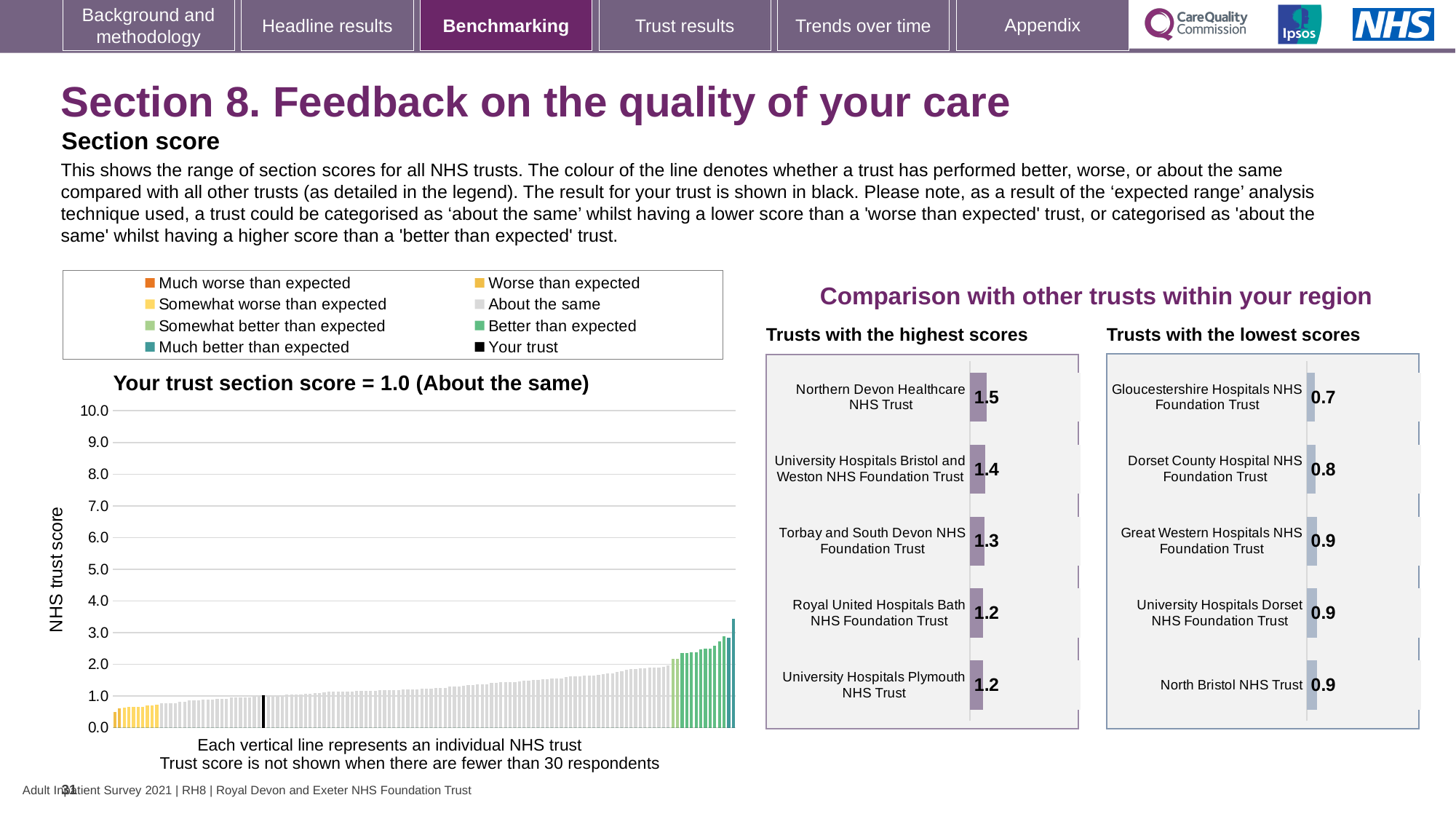
In the 'Trusts with the highest scores' chart, which trust has the highest score? Northern Devon Healthcare NHS Trust In the 'Trusts with the lowest scores' chart, which trust has the lowest score? Gloucestershire Hospitals NHS Foundation Trust In the 'Trusts with the lowest scores' chart, what is the score for Dorset County Hospital NHS Foundation Trust? 0.8 How many entries does the legend of the main section score chart list? 8 In the 'Trusts with the highest scores' chart, what is the score for Northern Devon Healthcare NHS Trust? 1.5 How many trusts are shown in the 'Trusts with the lowest scores' chart? 5 In the 'Trusts with the highest scores' chart, what is the score for Torbay and South Devon NHS Foundation Trust? 1.3 In the 'Trusts with the lowest scores' chart, what is the score for Gloucestershire Hospitals NHS Foundation Trust? 0.7 According to the main 'Your trust section score' chart, what is the section score for your trust? 1.0 In the main 'Your trust section score' chart, do the trust scores rise or fall from left to right? rise In the 'Trusts with the highest scores' chart, which has the larger score: University Hospitals Bristol and Weston NHS Foundation Trust or Royal United Hospitals Bath NHS Foundation Trust? University Hospitals Bristol and Weston NHS Foundation Trust In the 'Trusts with the highest scores' chart, what is the difference between the scores of Northern Devon Healthcare NHS Trust and Torbay and South Devon NHS Foundation Trust? 0.2